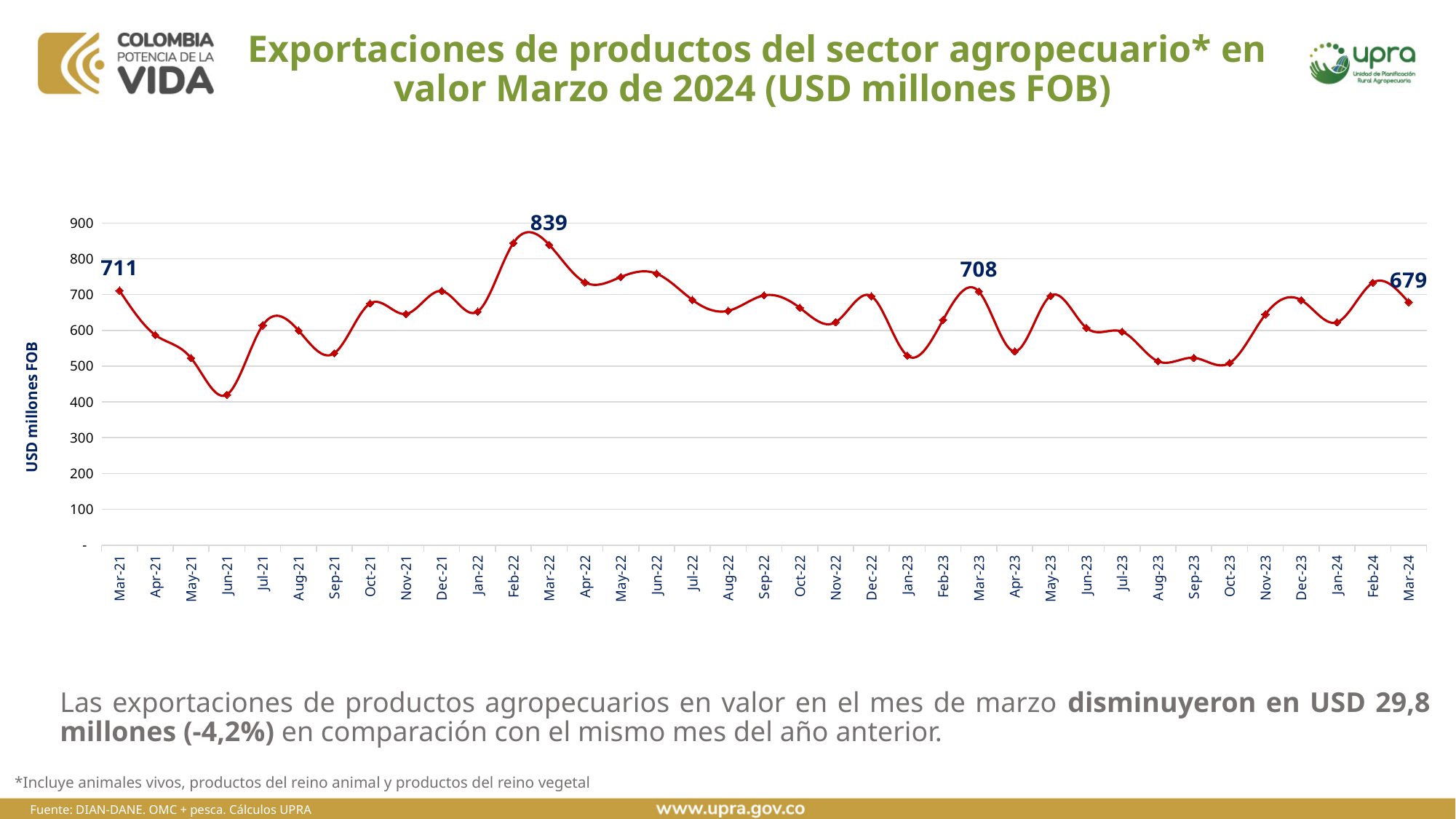
Which month has the lowest value on the chart? Jun-21 What kind of chart is shown on the slide? line chart What is the difference between the values for Mar-23 and Mar-24? 29 Is the value for Feb-22 greater or less than 800? greater What is the value for Mar-22? 839 What is the value for Mar-24? 679 What is the value for Mar-21? 711 What is the value for Mar-23? 708 What is the difference between the values for Mar-22 and Mar-21? 128 How many monthly data points are plotted on the chart? 37 Which is larger, the value for Mar-22 or the value for Mar-24? Mar-22 Is the value for Jun-21 greater or less than 500? less